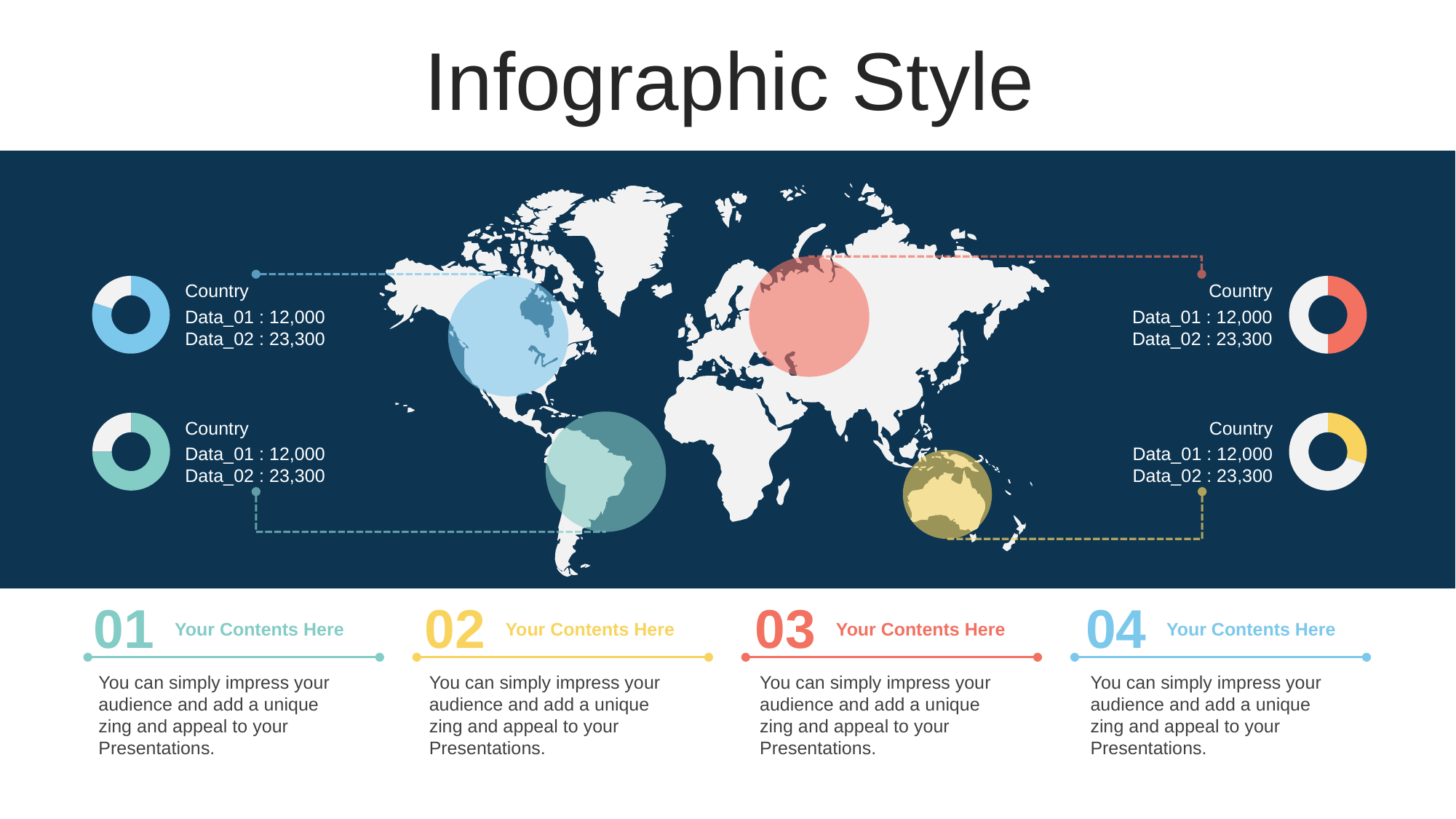
For the bottom-left donut chart, what is the difference between Data_02 and Data_01? 11,300 For the bottom-right donut chart, what is the value printed for Data_02? 23,300 For the top-right donut chart, which is larger, Data_01 or Data_02? Data_02 What kind of charts are the four small charts flanking the world map? Donut (pie) charts For the bottom-right donut chart, is the value for Data_01 greater or less than 20,000? less For the top-left donut chart, what is the value printed for Data_02? 23,300 For the top-left donut chart, what is the total of Data_01 and Data_02? 35,300 For the top-left donut chart, what is the value printed for Data_01? 12,000 What label is given for the category next to each donut chart? Country How many donut charts are shown on the slide? 4 How many data series (segments) does each donut chart show? 2 What colour is the highlighted segment of the top-right donut chart? Red